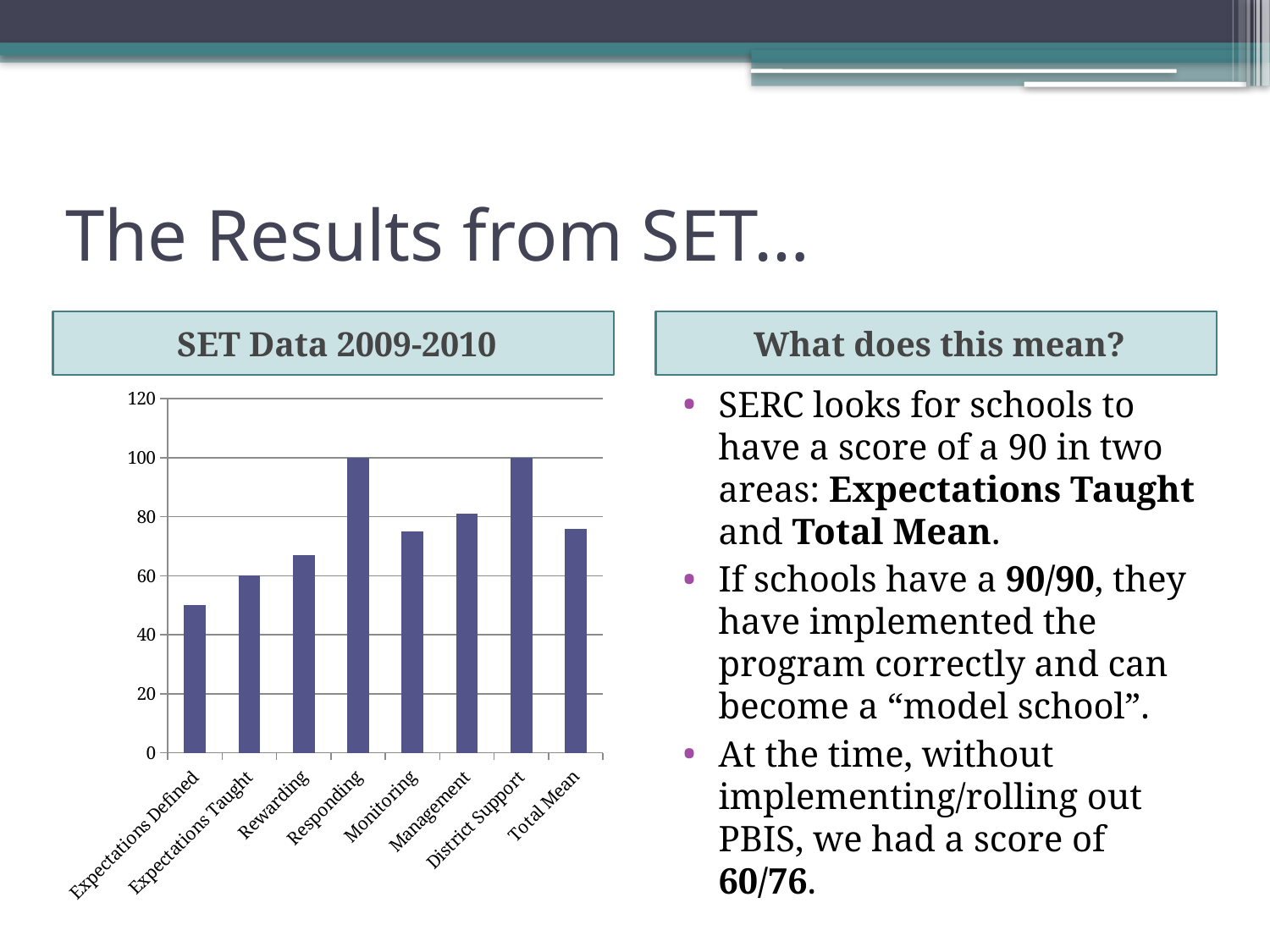
What is the value for District Support? 100 What type of chart is shown on the slide? bar chart Which category has the lowest value? Expectations Defined Is the value for Expectations Defined greater or less than 60? less What is the value for Expectations Taught? 60 What is the value for Responding? 100 Is the value for Monitoring greater or less than 80? less Is the value for Total Mean greater or less than 80? less Which is larger, the value for Management or the value for Monitoring? Management What is the title of the chart? SET Data 2009-2010 How many categories are shown on the x axis of the chart? 8